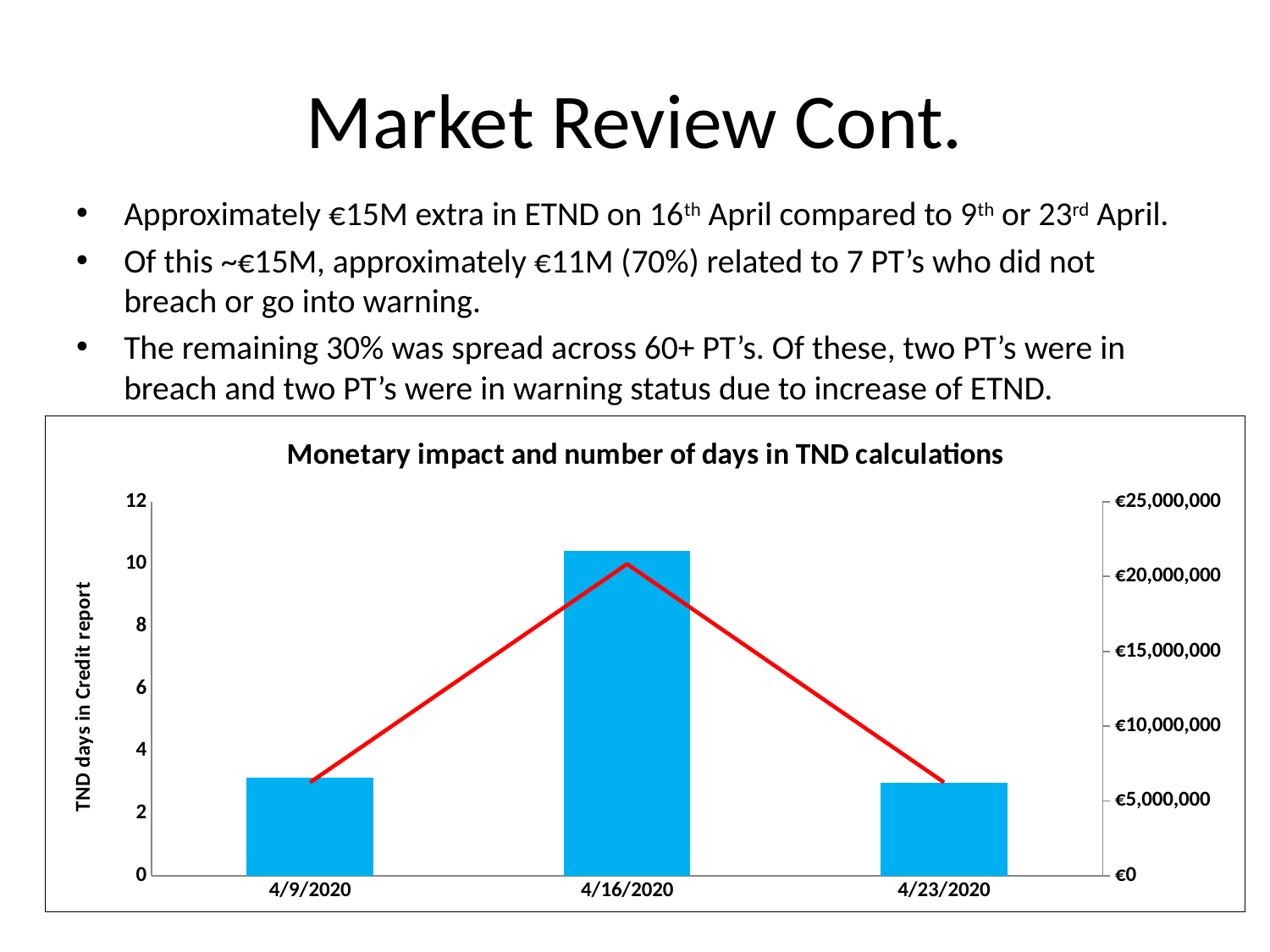
Is the bar value for 4/23/2020 greater or less than 4 on the left axis? less What is the title of the chart? Monetary impact and number of days in TND calculations Is the bar value for 4/9/2020 greater or less than 4 on the left axis? less Is the red line value for 4/9/2020 greater or less than €10,000,000 on the right axis? less Which date has the tallest bar in the chart? 4/16/2020 How many dates are shown on the x axis of the chart? 3 Does the red line rise or fall from 4/16/2020 to 4/23/2020? fall What is the label on the left vertical axis of the chart? TND days in Credit report Which has the larger bar value, 4/9/2020 or 4/16/2020? 4/16/2020 What kind of chart is shown on the slide? A bar chart combined with a line chart